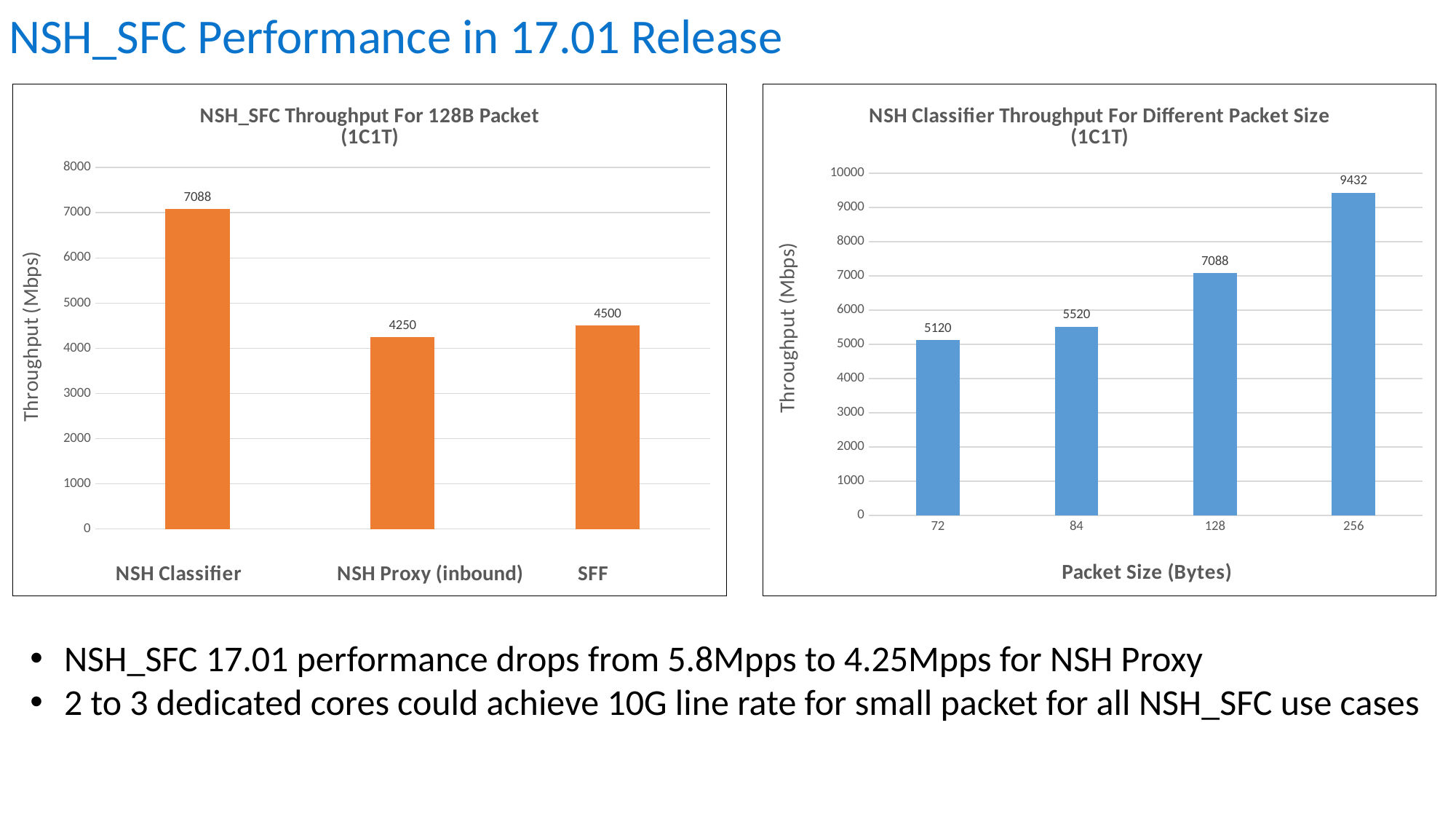
In the right chart (NSH Classifier Throughput For Different Packet Size), which packet size has the highest throughput? 256 In the left chart (NSH_SFC Throughput For 128B Packet), what is the throughput for NSH Classifier? 7088 What is the y-axis label of the left chart (NSH_SFC Throughput For 128B Packet)? Throughput (Mbps) In the left chart (NSH_SFC Throughput For 128B Packet), what is the difference between the NSH Classifier and SFF throughput values? 2588 In the right chart (NSH Classifier Throughput For Different Packet Size), do the values rise or fall as packet size increases along the x axis? rise In the right chart (NSH Classifier Throughput For Different Packet Size), what is the throughput for an 84-byte packet? 5520 In the left chart (NSH_SFC Throughput For 128B Packet), which category has the lowest throughput? NSH Proxy (inbound) In the left chart (NSH_SFC Throughput For 128B Packet), how many categories are plotted? 3 In the left chart (NSH_SFC Throughput For 128B Packet), what is the throughput for NSH Proxy (inbound)? 4250 What kind of chart is the right chart (NSH Classifier Throughput For Different Packet Size)? bar chart In the right chart (NSH Classifier Throughput For Different Packet Size), what is the throughput for a 256-byte packet? 9432 In the right chart (NSH Classifier Throughput For Different Packet Size), what is the difference in throughput between the 128-byte and 72-byte packet sizes? 1968